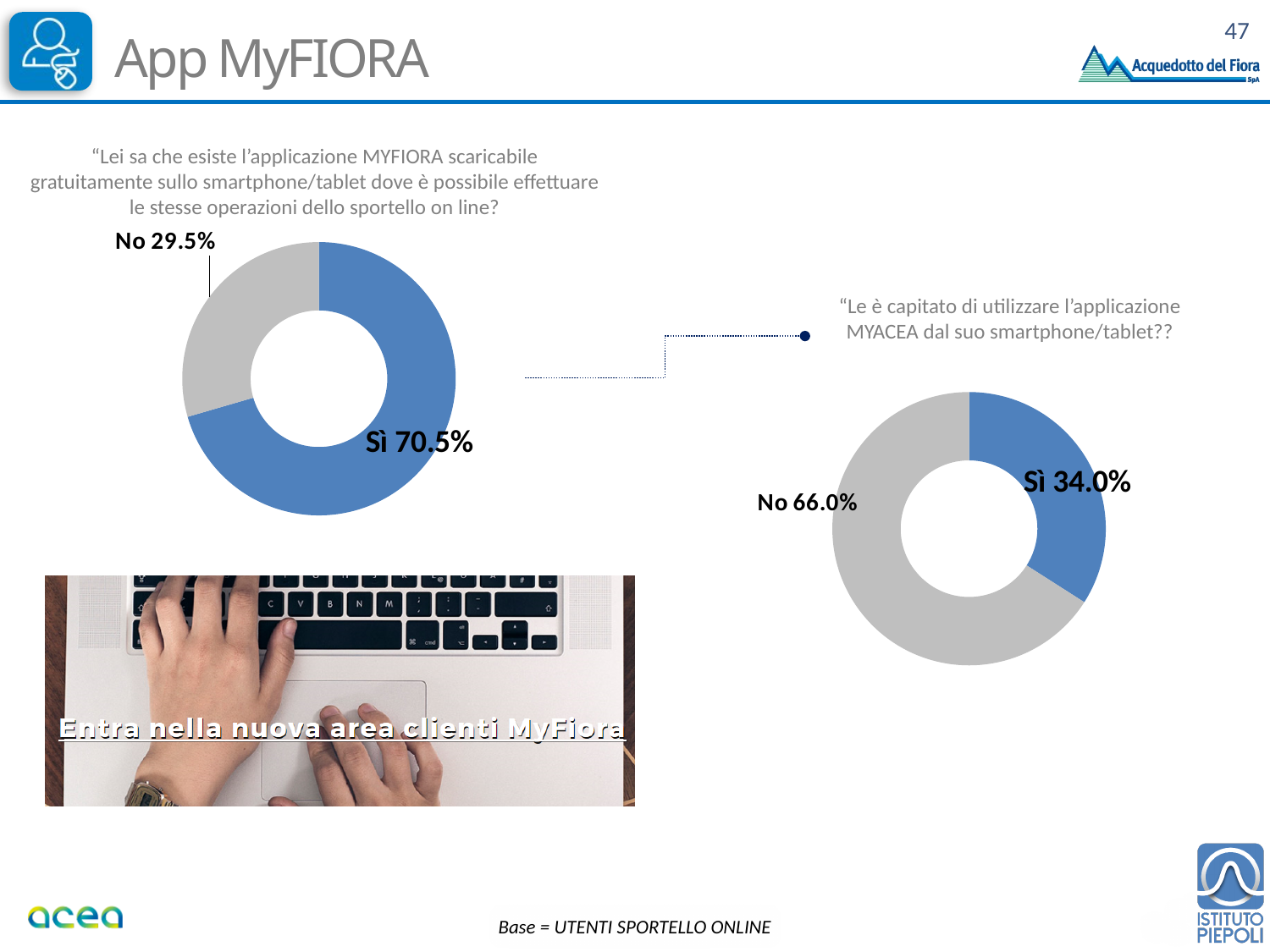
In the left chart, what is the difference in percentage points between "Sì" and "No"? 41.0 percentage points Which is larger: the "Sì" share in the left chart or the "Sì" share in the right chart? The left chart (70.5%) In the right chart (use of the app from smartphone/tablet), what percentage answered "Sì"? 34.0% In the left chart (awareness of the MYFIORA app), what percentage answered "No"? 29.5% In the right chart (use of the app from smartphone/tablet), what percentage answered "No"? 66.0% In the left chart, which answer has the largest share? Sì In the left chart (awareness of the MYFIORA app), what percentage answered "Sì"? 70.5% How many categories does the right chart show? 2 In the right chart, which colour represents the "No" answer? Grey In the right chart, what is the difference in percentage points between "No" and "Sì"? 32.0 percentage points What type of chart is used on the left of the slide? Donut (pie) chart In the right chart, which answer has the smallest share? Sì